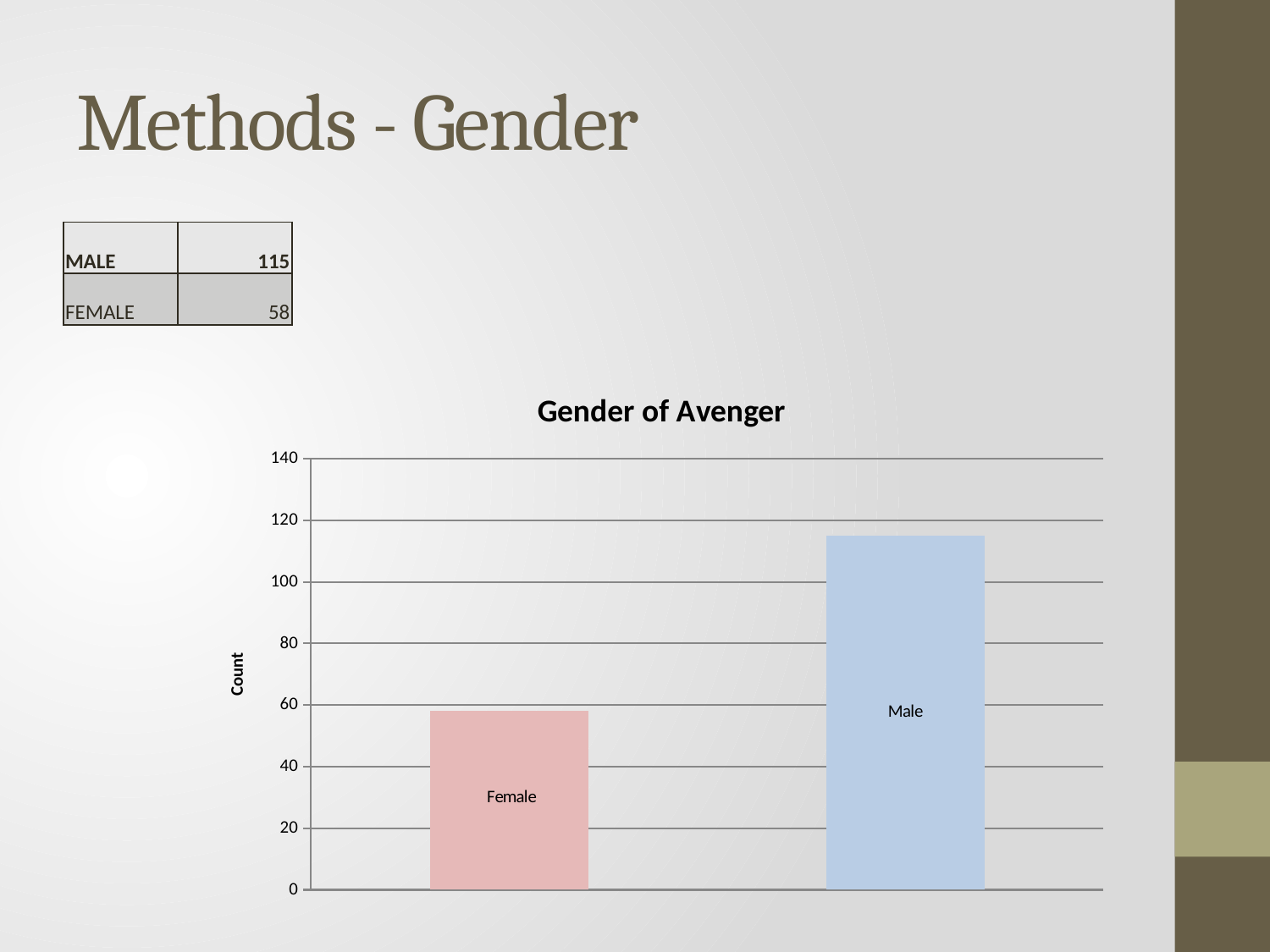
Which category has the lowest count in the Gender of Avenger chart? Female What is the label of the vertical axis in the Gender of Avenger chart? Count How many categories are plotted in the Gender of Avenger chart? 2 Is the value for Female greater or less than 60? less Which category has the highest count in the Gender of Avenger chart? Male What type of chart is shown on the slide? bar chart What is the count for Female in the Gender of Avenger chart? 58 What is the count for Male in the Gender of Avenger chart? 115 What is the title of the chart? Gender of Avenger Which is larger, the count for Male or the count for Female? Male Is the value for Male greater or less than 100? greater What is the difference between the Male and Female counts? 57